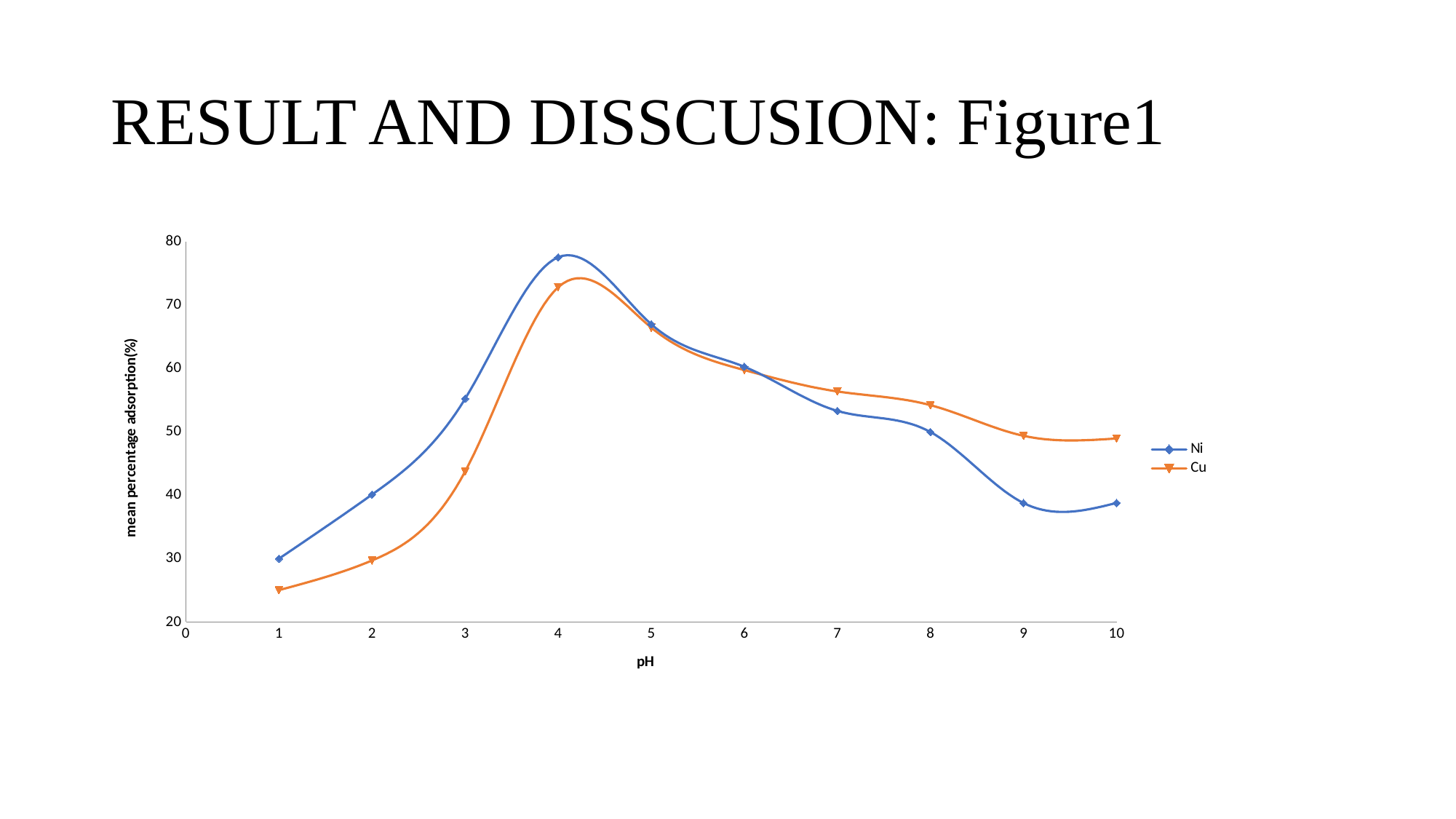
Is the Ni value at pH 4 greater or less than 70? greater Is the Cu value at pH 1 greater or less than 30? less What kind of chart is shown on the slide? line chart At pH 3, which series has the higher value, Ni or Cu? Ni From pH 4 to pH 9, does the Ni series rise or fall? fall How many pH data points are plotted for the Ni series? 10 At pH 9, which series has the higher value, Ni or Cu? Cu At which pH is the Ni series at its lowest value? 1 At which pH does the Cu series reach its highest mean percentage adsorption? 4 At which pH is the Cu series at its lowest value? 1 How many series does the legend list? 2 At which pH does the Ni series reach its highest mean percentage adsorption? 4